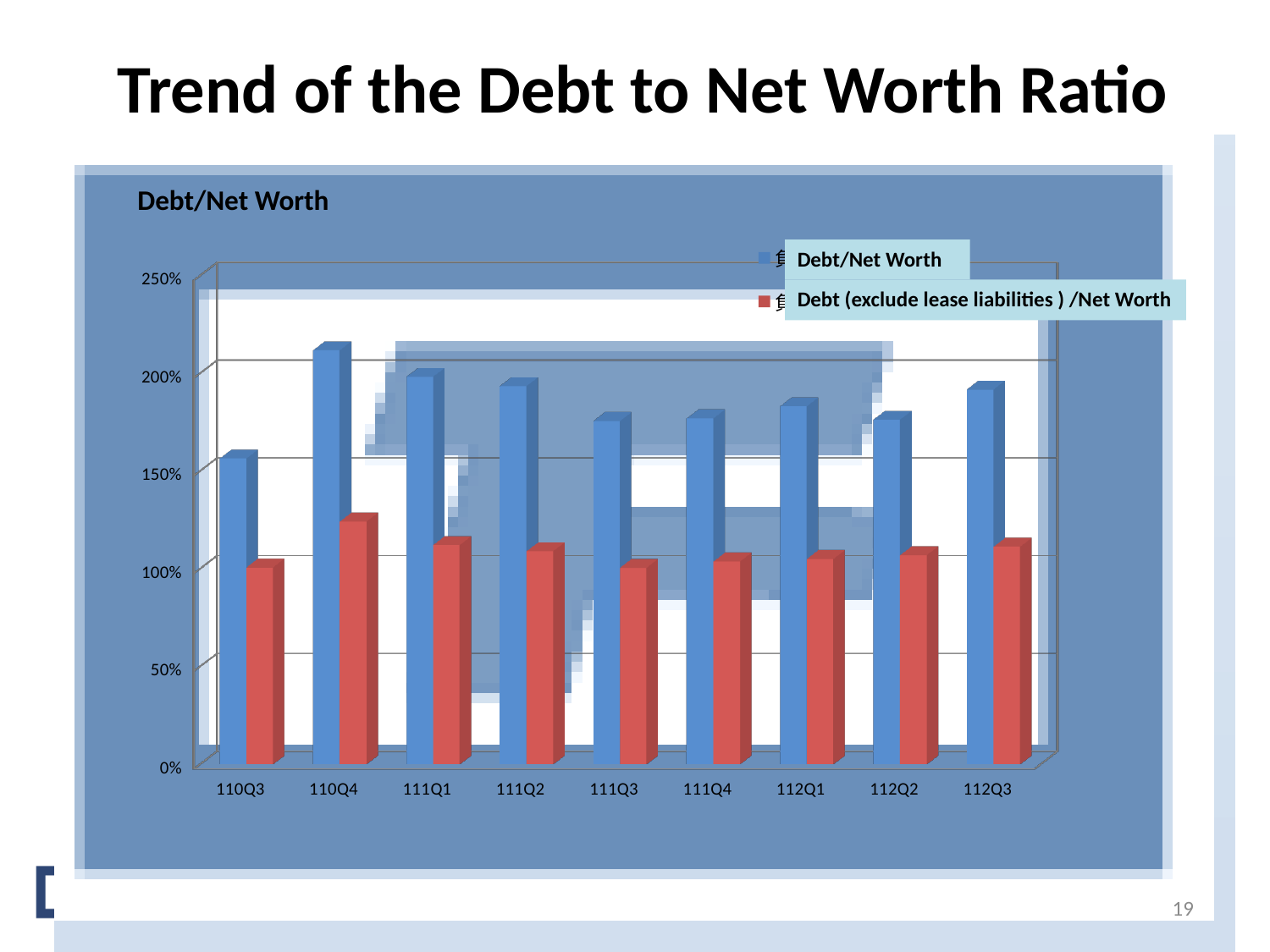
What is the title shown inside the chart area? Debt/Net Worth What kind of chart is shown on the slide? Bar chart Is the Debt (exclude lease liabilities) /Net Worth value for 110Q4 greater or less than 100%? greater In which quarter is the Debt/Net Worth ratio highest? 110Q4 How many quarters are shown on the x axis of the chart? 9 Is the Debt/Net Worth value for 111Q3 greater or less than 200%? less Which is larger, the Debt/Net Worth value for 110Q3 or for 112Q3? 112Q3 In which quarter is the Debt/Net Worth ratio lowest? 110Q3 How many series does the chart's legend list? 2 In which quarter is the Debt (exclude lease liabilities) /Net Worth ratio highest? 110Q4 Is the Debt/Net Worth value for 110Q4 greater or less than 200%? greater Which series is shown in red in the chart? Debt (exclude lease liabilities ) /Net Worth